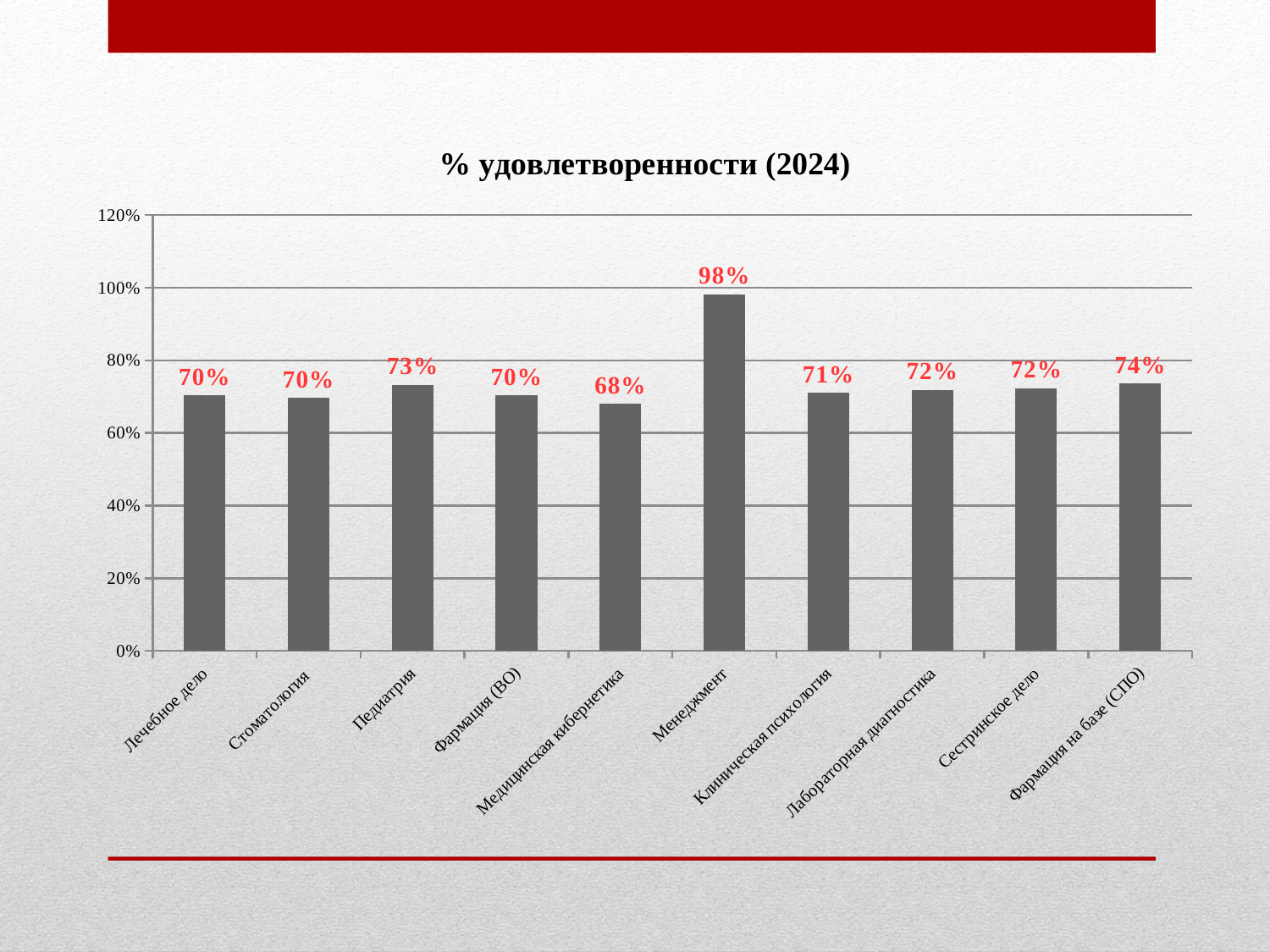
What is the value for Педиатрия? 73% What is the difference between the values for Фармация на базе (СПО) and Стоматология? 4% How many categories are shown on the x axis? 10 What type of chart is shown on the slide? bar chart Is the value for Менеджмент greater or less than 80%? greater What is the difference between the values for Менеджмент and Медицинская кибернетика? 30% What is the value for Медицинская кибернетика? 68% Which category has the lowest value? Медицинская кибернетика What is the value for Фармация на базе (СПО)? 74% Which is larger, the value for Педиатрия or the value for Клиническая психология? Педиатрия What is the value for Менеджмент? 98% Which category has the highest value? Менеджмент